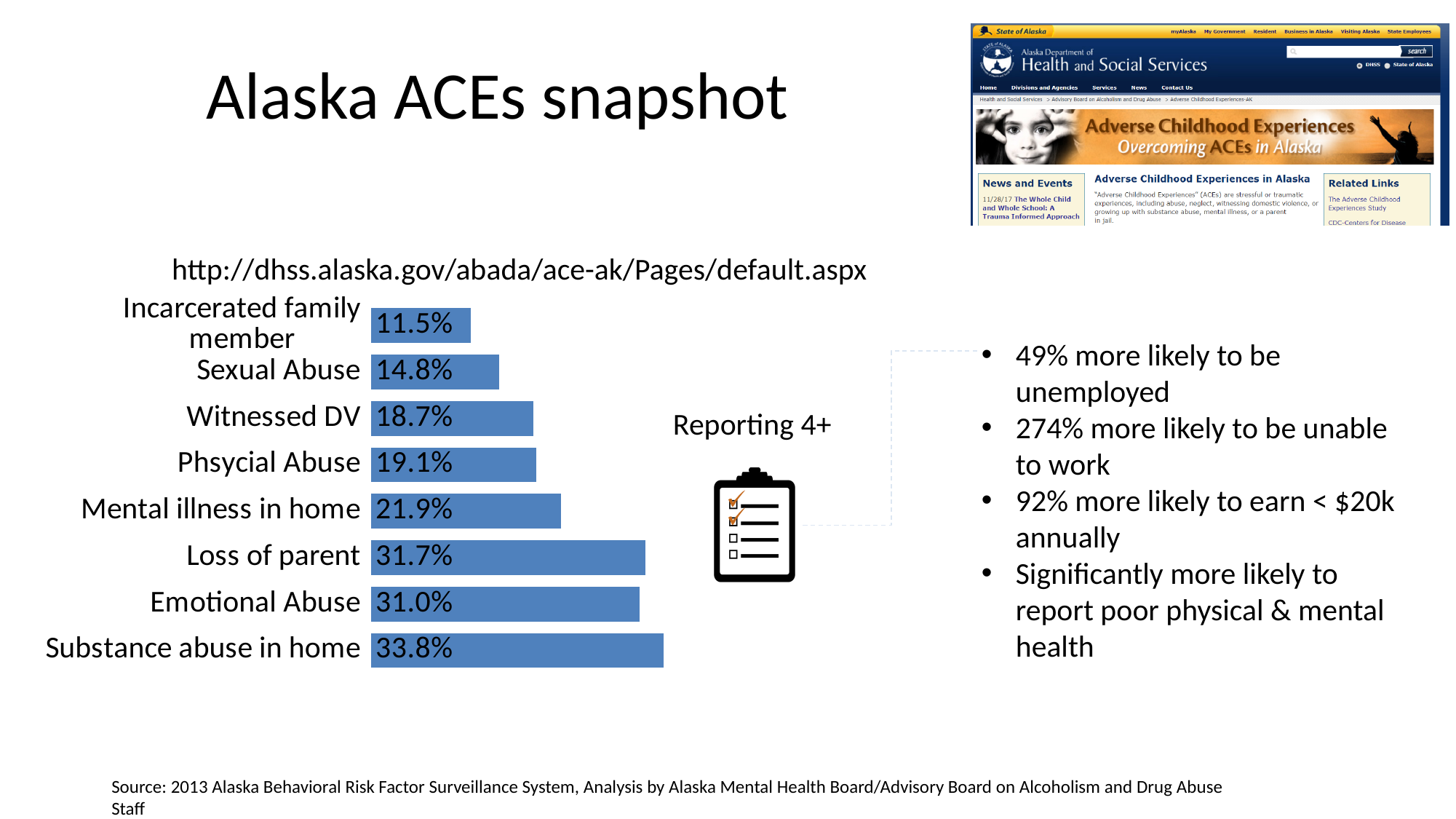
Which is larger, Phsycial Abuse or Witnessed DV? Phsycial Abuse Which category has the lowest value? Incarcerated family member What is the value for Witnessed DV? 18.7% Which is larger, Sexual Abuse or Mental illness in home? Mental illness in home What kind of chart is shown on the slide? bar chart What is the difference between Loss of parent and Emotional Abuse? 0.7% What is the value for Loss of parent? 31.7% What is the value for Substance abuse in home? 33.8% Which category has the highest value? Substance abuse in home What is the value for Incarcerated family member? 11.5% What is the difference between Mental illness in home and Sexual Abuse? 7.1% How many categories are shown in the chart? 8